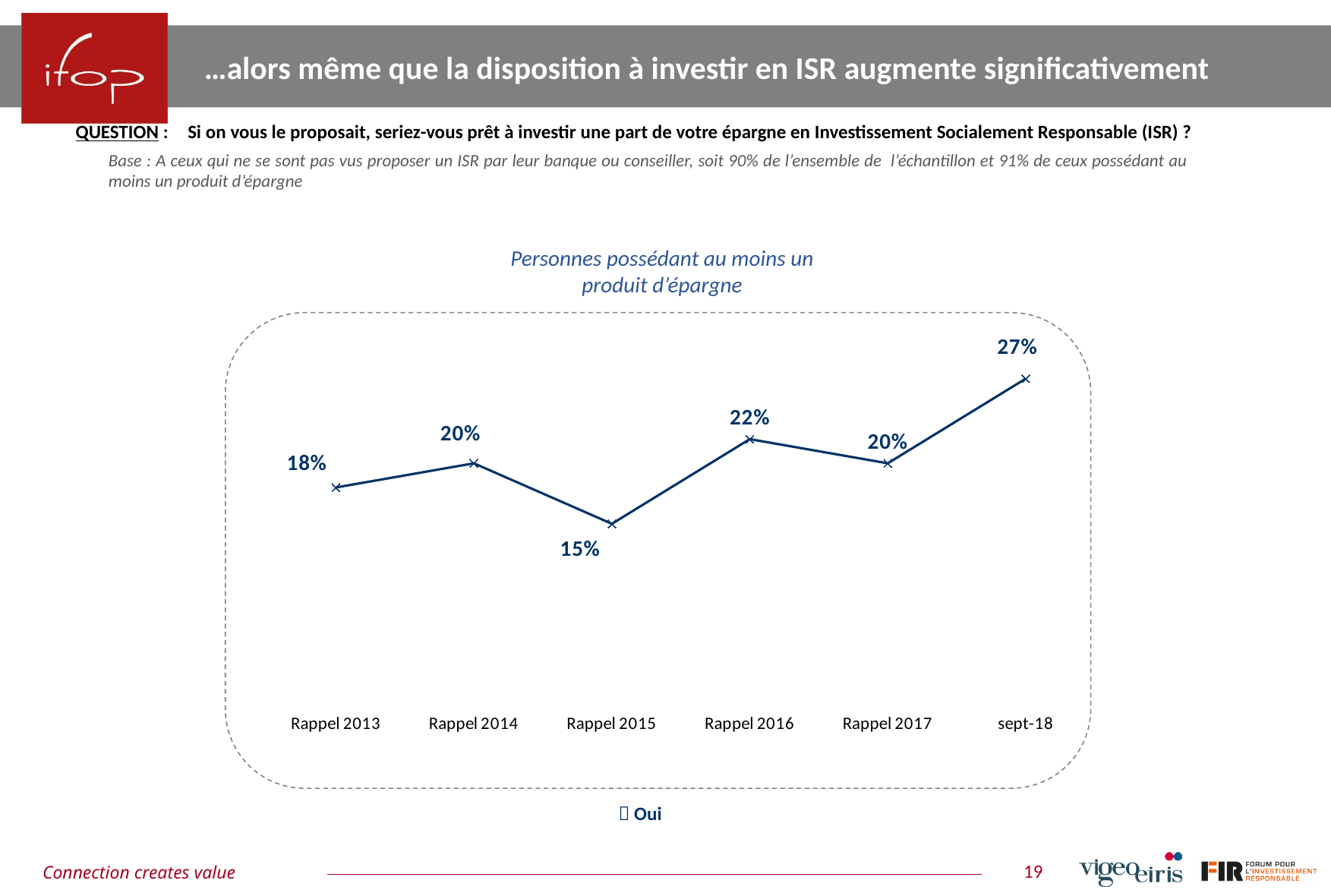
What is the value for sept-18? 27% How many data points are plotted on the chart? 6 Which category has the highest value? sept-18 What is the difference between the values for sept-18 and Rappel 2017? 7% Does the value rise or fall from Rappel 2017 to sept-18? rise What kind of chart is shown on the slide? line chart What is the title of the chart? Personnes possédant au moins un produit d'épargne What is the value for Rappel 2016? 22% What is the value for Rappel 2013? 18% Which category has the lowest value? Rappel 2015 What is the value for Rappel 2015? 15% Which is larger, the value for Rappel 2016 or the value for Rappel 2015? Rappel 2016